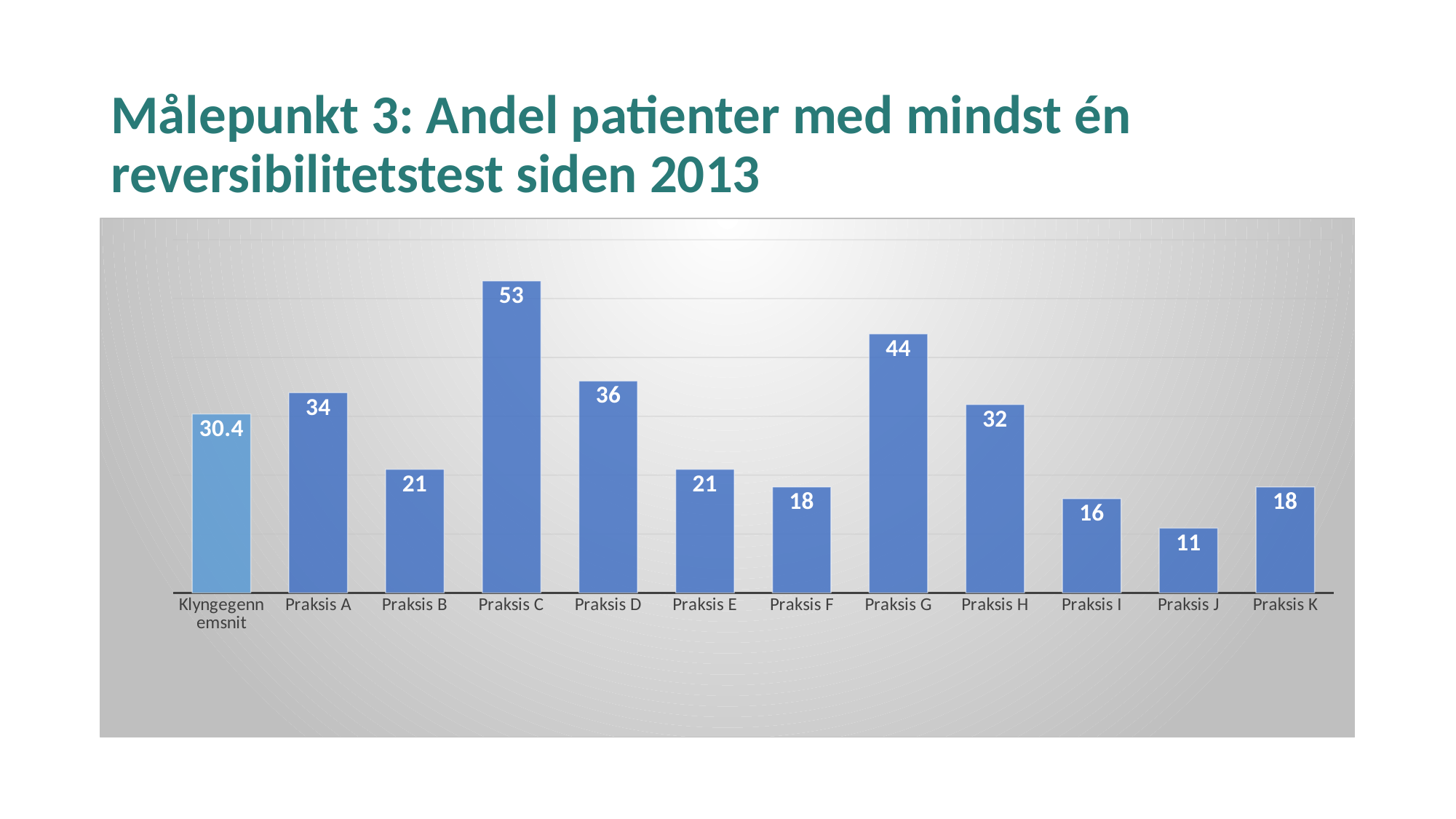
Which category has the highest value? Praksis C Which categories have a value of 21? Praksis B and Praksis E Which is larger, the value for Praksis D or the value for Praksis H? Praksis D What is the value for Praksis C? 53 What is the difference between the values for Praksis A and Praksis I? 18 Which bar is shown in a lighter blue colour than the others? Klyngegennemsnit What kind of chart is shown on the slide? Bar chart How many categories are shown on the x axis? 12 What is the value for Praksis J? 11 Which category has the lowest value? Praksis J What is the value for Klyngegennemsnit? 30.4 What is the difference between the values for Praksis C and Praksis G? 9